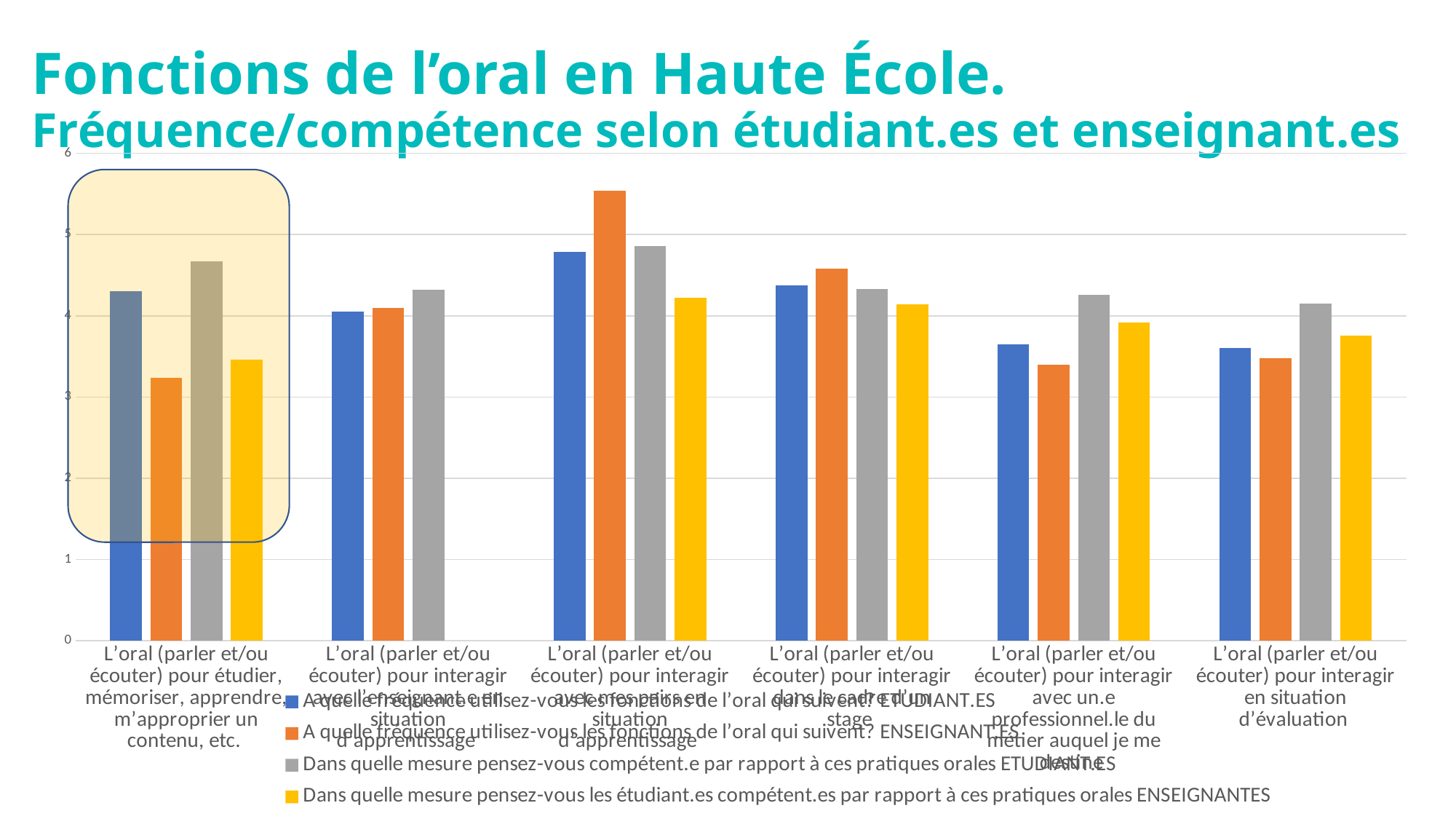
Is the value for 'Dans quelle mesure pensez-vous compétent.e par rapport à ces pratiques orales ETUDIANT.ES' in the category 'L'oral (parler et/ou écouter) pour étudier, mémoriser, apprendre, m'approprier un contenu, etc.' greater or less than 4? greater Is the value for 'A quelle fréquence utilisez-vous les fonctions de l'oral qui suivent? ETUDIANT.ES' in the category 'L'oral (parler et/ou écouter) pour interagir en situation d'évaluation' greater or less than 4? less Which colour represents the series 'Dans quelle mesure pensez-vous les étudiant.es compétent.es par rapport à ces pratiques orales ENSEIGNANTES' in the legend? yellow Is the value for 'A quelle fréquence utilisez-vous les fonctions de l'oral qui suivent? ENSEIGNANT.ES' in the category 'L'oral (parler et/ou écouter) pour interagir avec mes pairs en situation d'apprentissage' greater or less than 5? greater In the category 'L'oral (parler et/ou écouter) pour interagir avec un.e professionnel.le du métier auquel je me destine', which is larger: the value for 'Dans quelle mesure pensez-vous compétent.e par rapport à ces pratiques orales ETUDIANT.ES' or the value for 'A quelle fréquence utilisez-vous les fonctions de l'oral qui suivent? ENSEIGNANT.ES'? Dans quelle mesure pensez-vous compétent.e par rapport à ces pratiques orales ETUDIANT.ES In the category 'L'oral (parler et/ou écouter) pour étudier, mémoriser, apprendre, m'approprier un contenu, etc.', which series has the lowest value? A quelle fréquence utilisez-vous les fonctions de l'oral qui suivent? ENSEIGNANT.ES Which category has the highest value for the series 'A quelle fréquence utilisez-vous les fonctions de l'oral qui suivent? ENSEIGNANT.ES'? L'oral (parler et/ou écouter) pour interagir avec mes pairs en situation d'apprentissage What is the first line of the slide's title? Fonctions de l'oral en Haute École. How many series does the chart's legend list? 4 How many categories are shown along the x axis of the chart? 6 What kind of chart is shown on the slide? bar chart